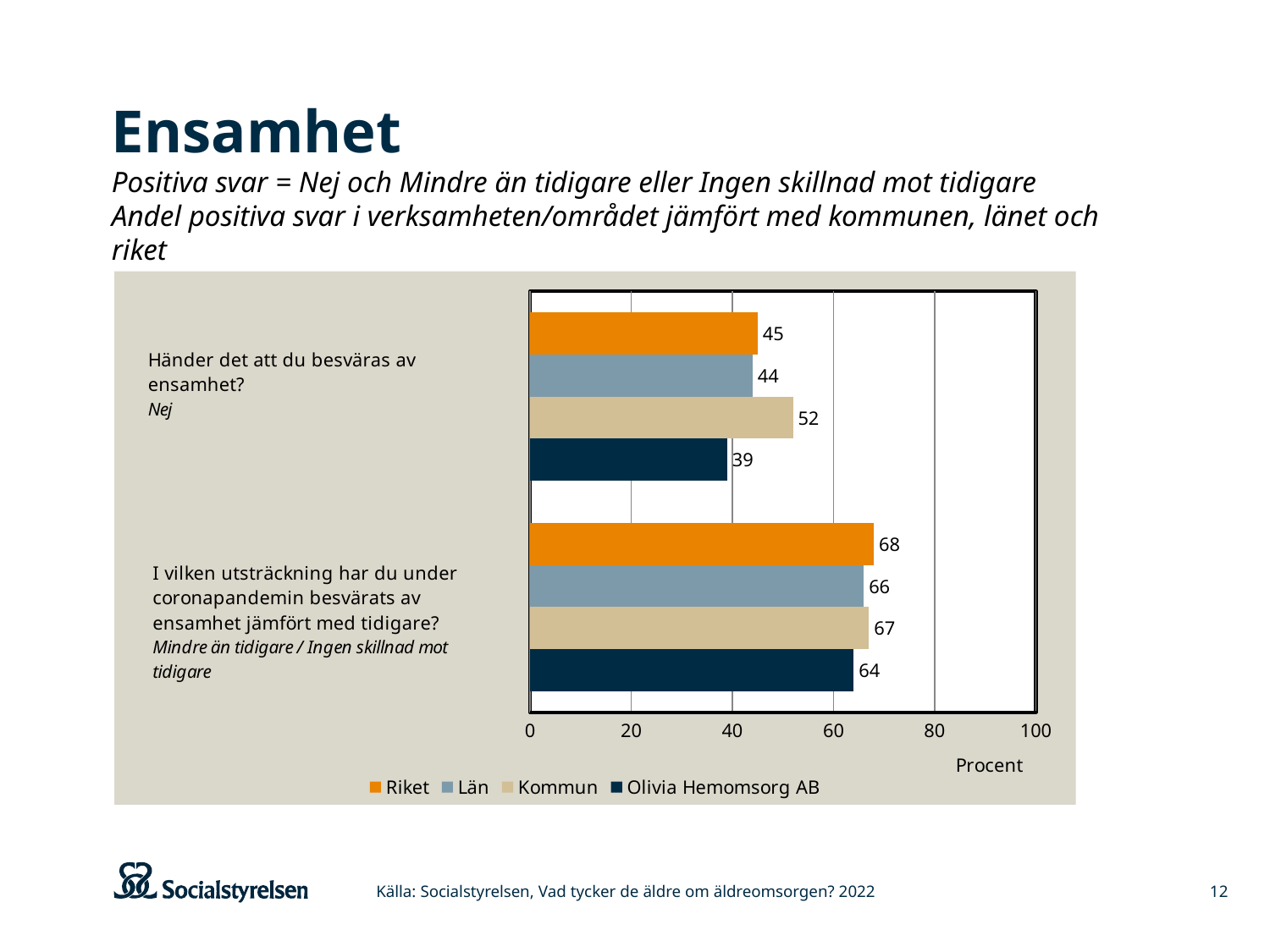
What kind of chart is shown on the slide? Bar chart What unit is labelled on the horizontal axis of the chart? Procent What value is shown for Kommun on the question 'Händer det att du besväras av ensamhet?' 52 What value is shown for Olivia Hemomsorg AB on the question 'I vilken utsträckning har du under coronapandemin besvärats av ensamhet jämfört med tidigare?' 64 What is the difference between the Kommun and Olivia Hemomsorg AB values for the question 'Händer det att du besväras av ensamhet?' 13 Which series has the highest value for the question 'Händer det att du besväras av ensamhet?' Kommun What value is shown for Riket on the question 'Händer det att du besväras av ensamhet?' 45 Is the value for Olivia Hemomsorg AB on the question 'Händer det att du besväras av ensamhet?' greater or less than 40? less How many series does the legend list? 4 Which is larger for the question 'I vilken utsträckning har du under coronapandemin besvärats av ensamhet jämfört med tidigare?': Riket or Län? Riket Which series has the lowest value for the question 'I vilken utsträckning har du under coronapandemin besvärats av ensamhet jämfört med tidigare?' Olivia Hemomsorg AB How many question categories are shown on the chart? 2